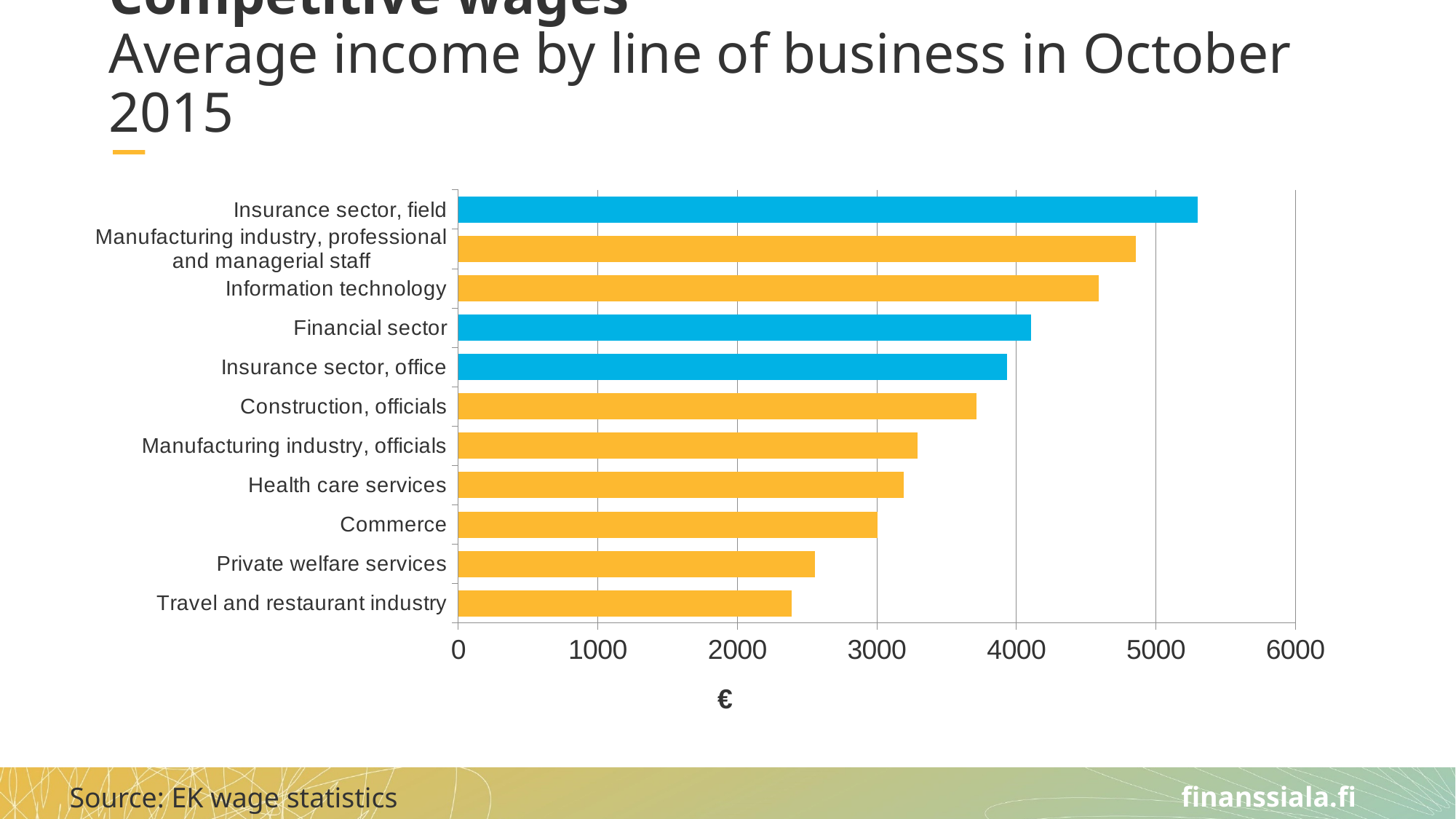
Which line of business has the highest average income? Insurance sector, field Is the value for Travel and restaurant industry greater or less than 3000? less Is the value for Information technology greater or less than 5000? less Is the value for Construction, officials greater or less than 4000? less What kind of chart is shown on the slide? bar chart Which has a higher average income, Construction, officials or Commerce? Construction, officials Which line of business has the lowest average income? Travel and restaurant industry What unit is shown on the horizontal axis label? € How many lines of business are shown in the chart? 11 Which has a higher average income, Insurance sector, field or Financial sector? Insurance sector, field